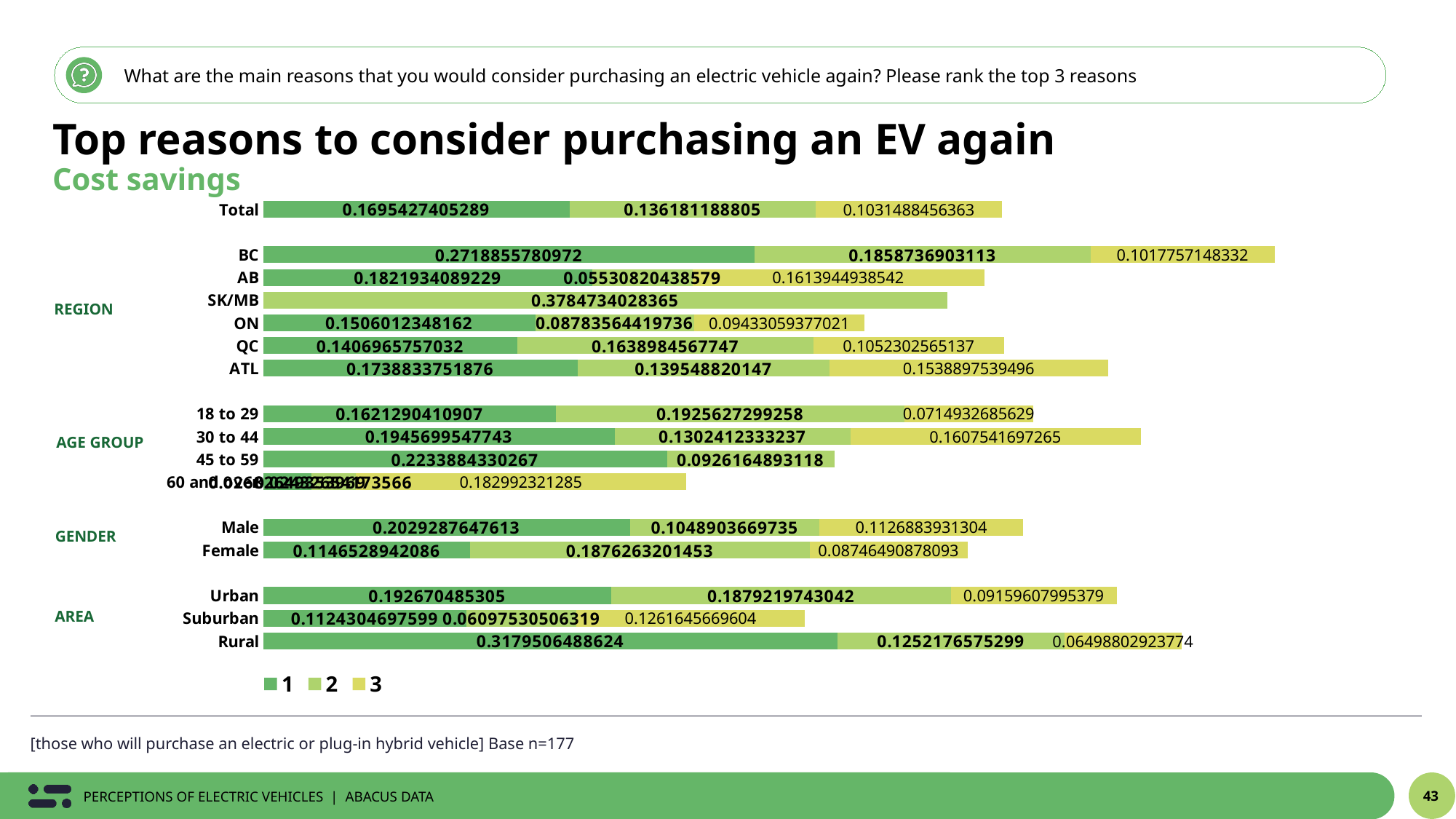
What is the value of series 1 for Total? 0.1695427405289 Which has the larger series 1 value, Male or Female? Male How many series does the legend list? 3 Which category has the largest series 1 value? Rural What is the value of series 1 for BC? 0.2718855780972 What is the difference between the series 1 and series 2 values for Total? 0.0333615517239 What is the total of the stacked bar for Total? 0.4088727749702 What is the value of series 3 for Urban? 0.09159607995379 What kind of chart is shown on the slide? Stacked bar chart What are the legend entries of the chart? 1, 2, 3 What is the value of series 1 for Rural? 0.3179506488624 What is the value of series 2 for SK/MB? 0.3784734028365